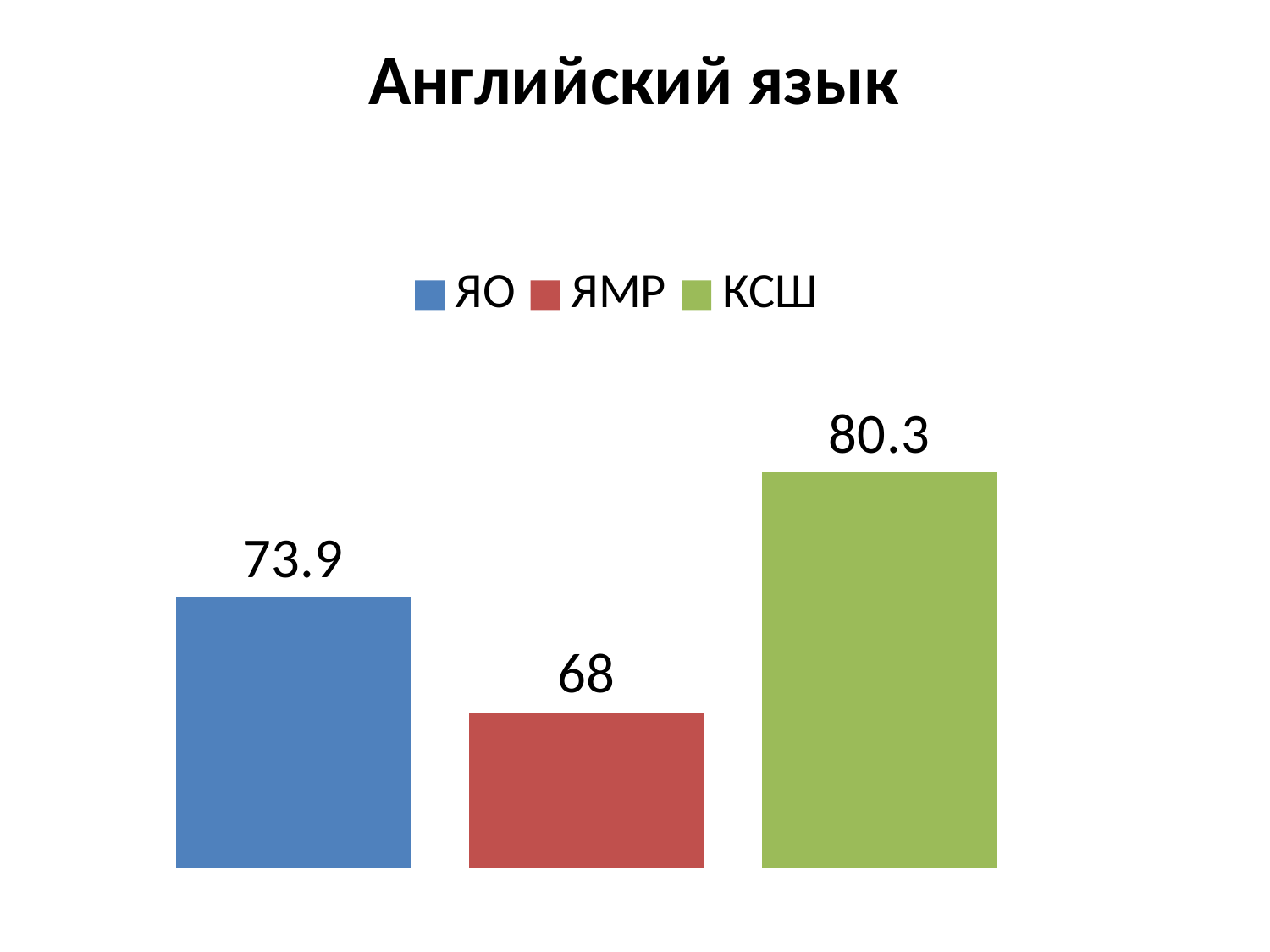
How many bars are shown in the chart? 3 What is the value for ЯМР? 68 Which is larger, the value for ЯО or the value for ЯМР? ЯО What is the value for КСШ? 80.3 What is the difference between the values for КСШ and ЯО? 6.4 What kind of chart is shown on the slide? bar chart What is the value for ЯО? 73.9 Which series has the lowest value? ЯМР How many series does the legend list? 3 What is the difference between the values for ЯО and ЯМР? 5.9 What is the title of the chart? Английский язык Which series has the highest value? КСШ